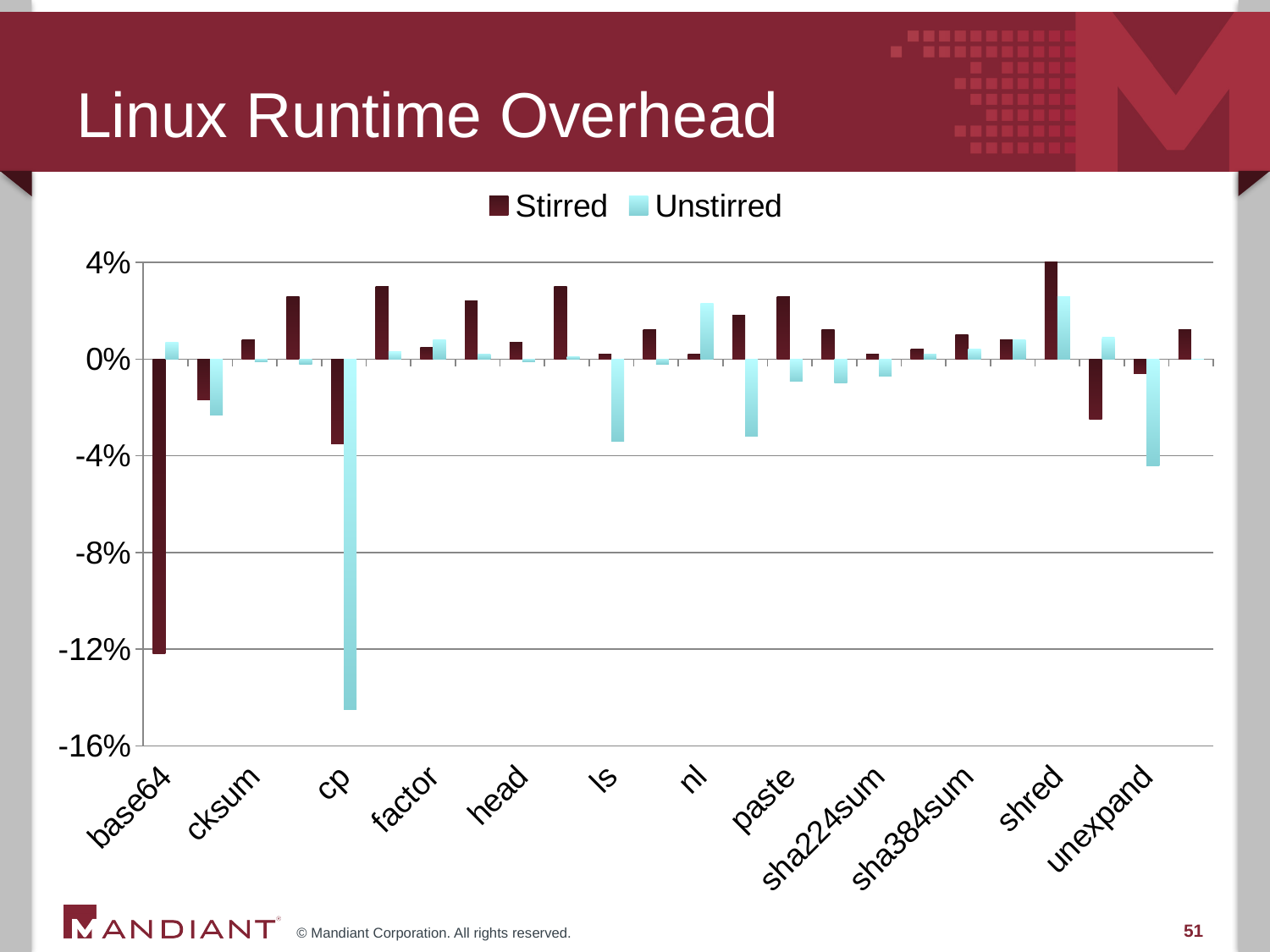
What kind of chart is shown on the slide? bar chart Which category has the lowest Stirred value? base64 Is the Stirred value for base64 greater or less than -8%? less Which category has the highest Stirred value? shred Which category has the lowest Unstirred value? cp For cp, which is larger, the Stirred value or the Unstirred value? Stirred How many series does the legend list? 2 Is the Unstirred value for cp greater or less than -12%? less What is the title of the slide containing the chart? Linux Runtime Overhead Is the Unstirred value for base64 greater or less than -4%? greater Which is larger, the Stirred value for base64 or the Stirred value for cp? cp What are the two series named in the legend? Stirred and Unstirred